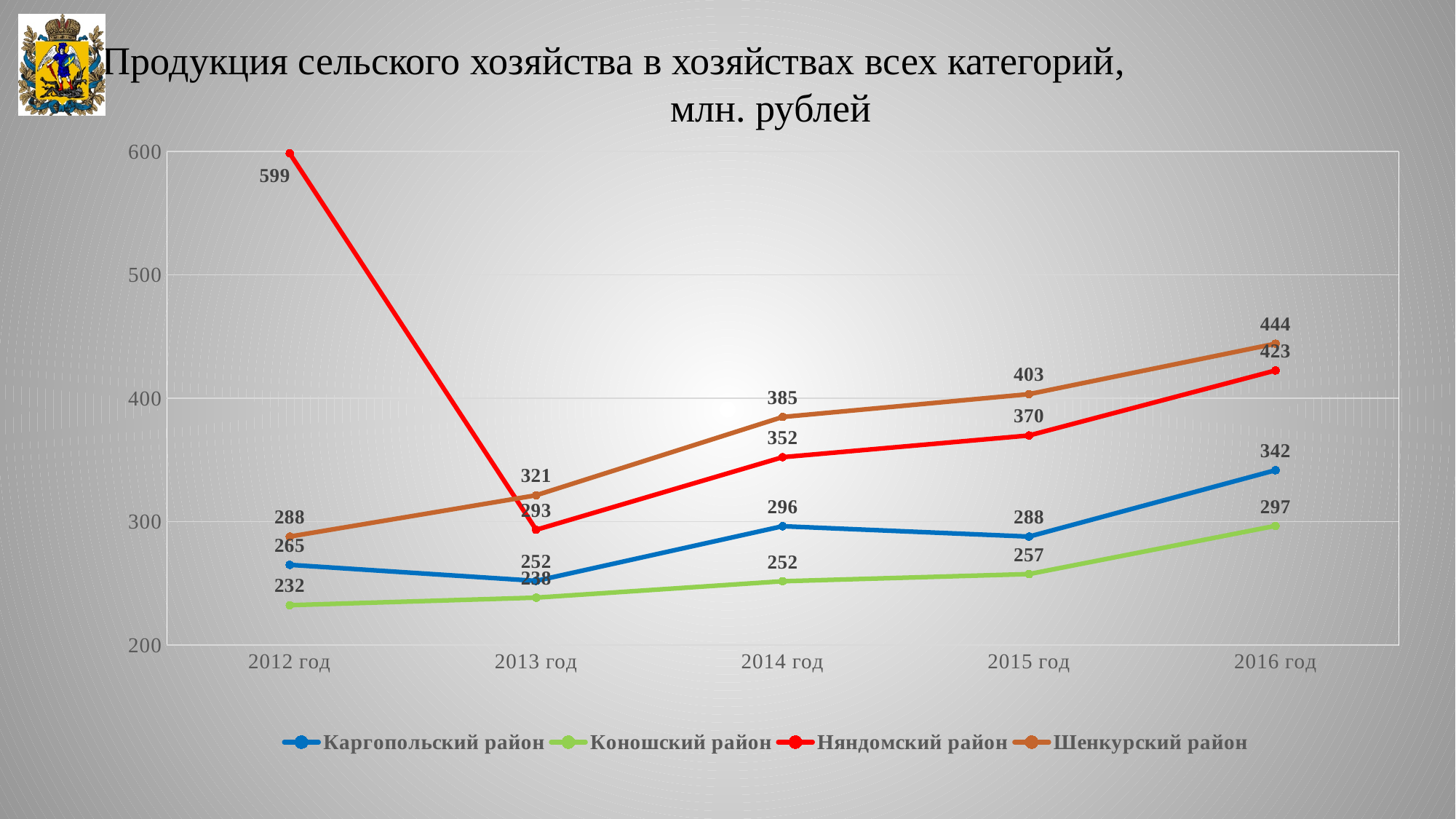
Which district has the lowest value in 2012 год? Коношский район What is the value for Няндомский район in 2012 год? 599 What is the value for Коношский район in 2014 год? 252 How many series does the legend list? 4 What type of chart is shown on the slide? line chart What is the value for Шенкурский район in 2016 год? 444 Which district has the highest value in 2016 год? Шенкурский район Does the value for Коношский район rise or fall from 2012 год to 2016 год? rise Which is larger in 2014 год: Шенкурский район or Няндомский район? Шенкурский район How many years are shown on the x axis? 5 What is the difference between the Няндомский район values in 2012 год and 2013 год? 306 What is the value for Каргопольский район in 2015 год? 288